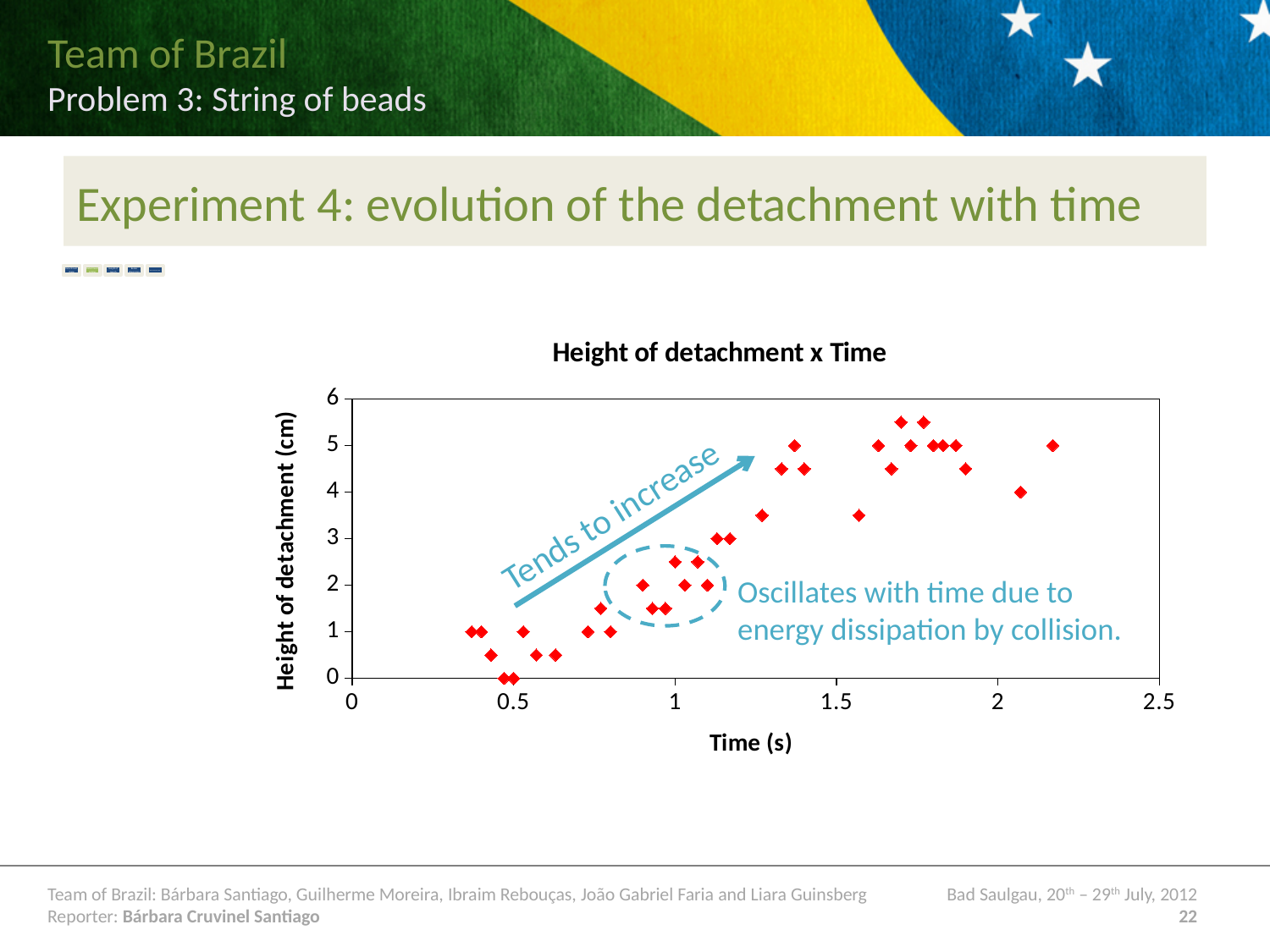
Is the highest height of detachment plotted greater or less than 5 cm? greater Are the points plotted at times below 0.5 s greater or less than 2 cm in height? less What is the label of the vertical axis of the chart? Height of detachment (cm) What kind of chart is shown on the slide? scatter chart What is the maximum value shown on the time axis? 2.5 What is the title of the chart? Height of detachment x Time Do the height of detachment values tend to rise or fall as time increases? rise Is the height of detachment for the point at about 2.2 s greater or less than 4 cm? greater Which has the larger height of detachment: the points near 0.5 s or the points near 1.7 s? the points near 1.7 s